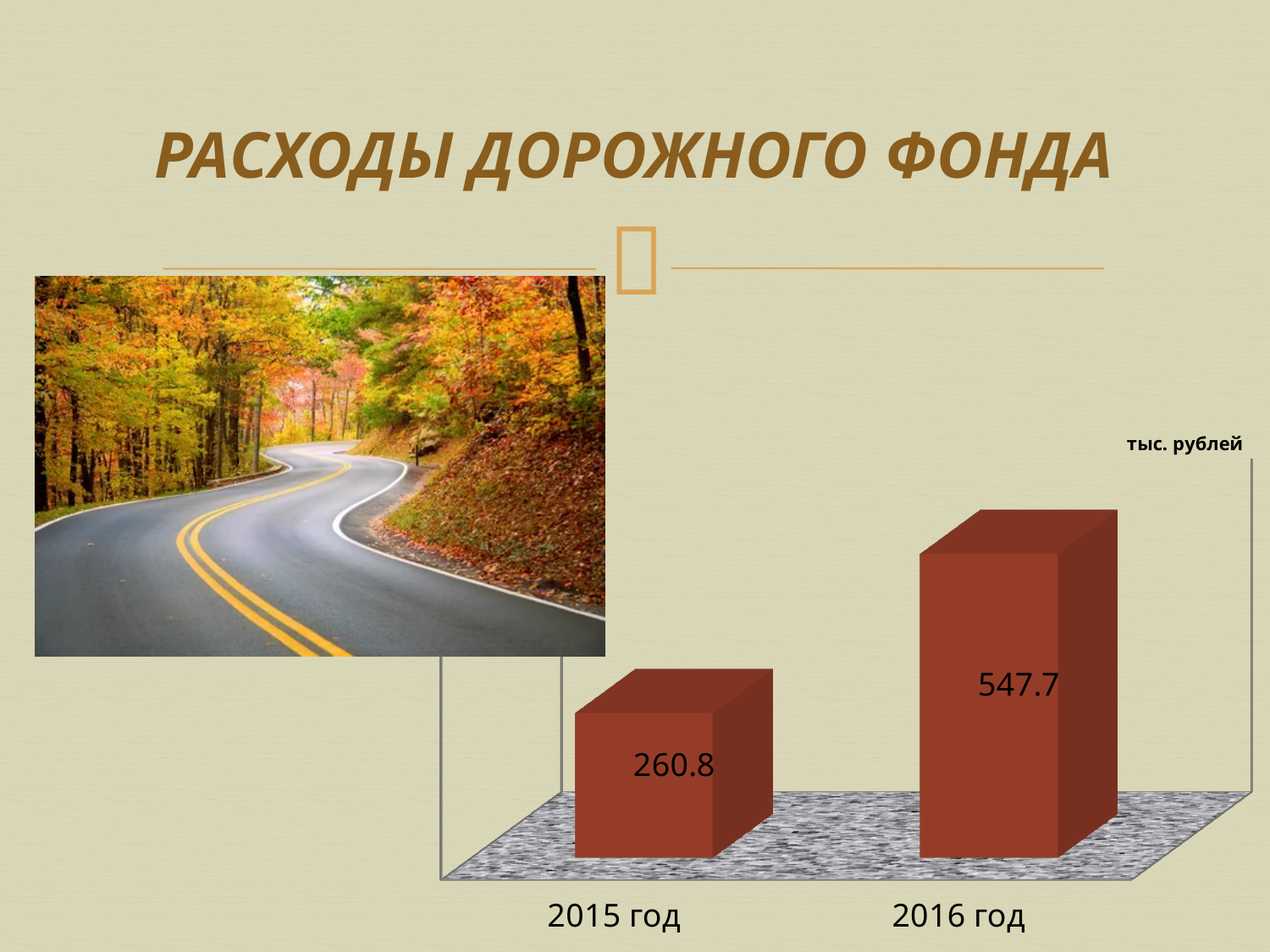
What kind of chart is shown on the slide? bar chart Do the values rise or fall from 2015 год to 2016 год? rise How many categories are shown in the chart? 2 Which is larger, the value for 2015 год or the value for 2016 год? 2016 год Which year has the highest value? 2016 год What is the total of the values for 2015 год and 2016 год? 808.5 What is the difference between the values for 2016 год and 2015 год? 286.9 Which year has the lowest value? 2015 год What is the value for 2015 год? 260.8 What unit is indicated for the chart values? тыс. рублей What is the title of the slide containing the chart? РАСХОДЫ ДОРОЖНОГО ФОНДА What is the value for 2016 год? 547.7